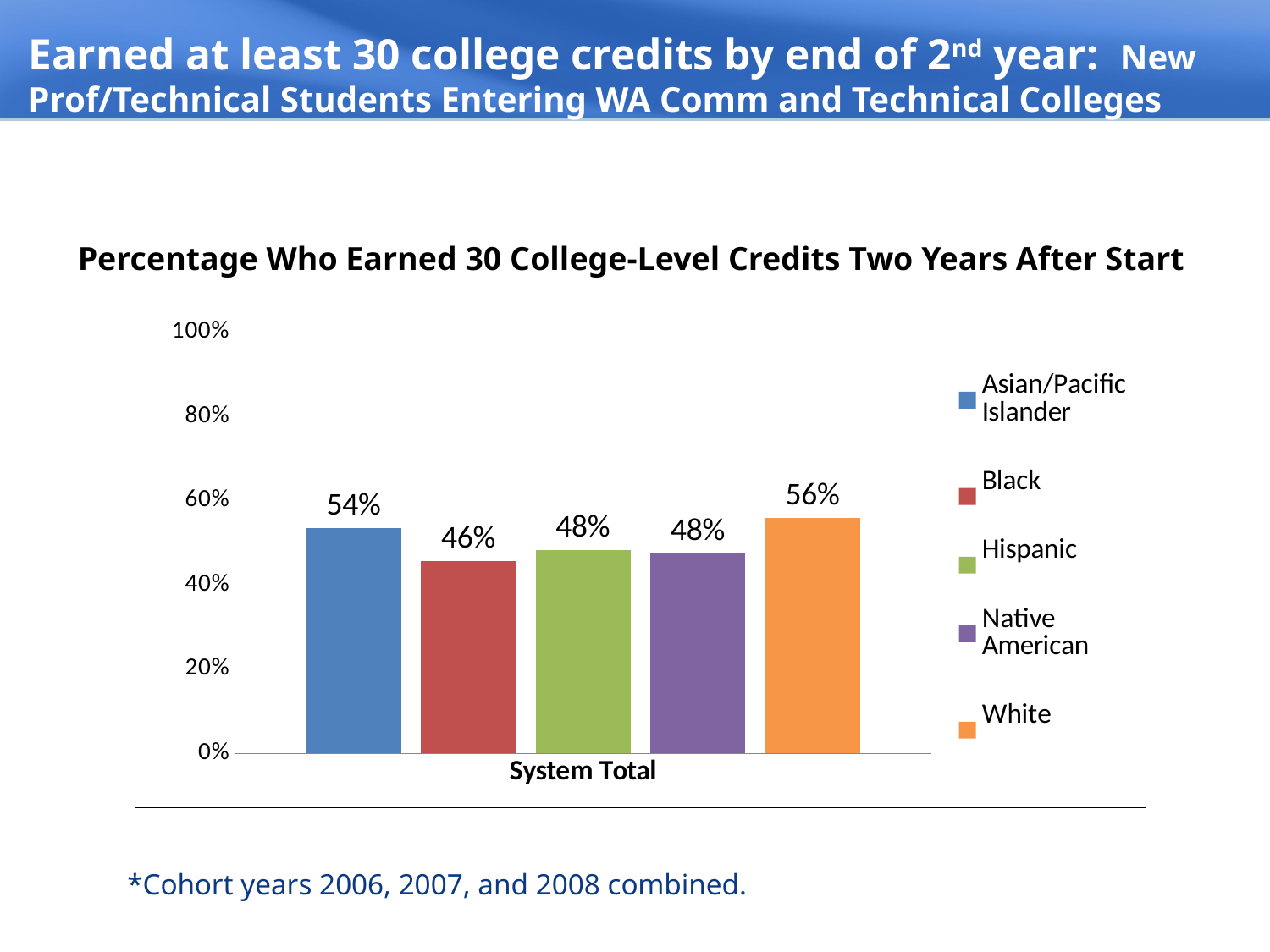
Is the value for Black students greater or less than 60%? less Which group has the highest percentage who earned 30 college-level credits? White What is the difference in percentage points between White and Black students? 10 What is the label on the x axis of the chart? System Total What percentage of Asian/Pacific Islander students earned 30 college-level credits two years after start? 54% What is the difference in percentage points between Asian/Pacific Islander and Hispanic students? 6 How many series does the legend list? 5 What is the value shown for Black students? 46% What is the value shown for White students? 56% Which is larger, the value for Asian/Pacific Islander or the value for Native American? Asian/Pacific Islander Which group has the lowest percentage who earned 30 college-level credits? Black What kind of chart is shown on the slide? bar chart